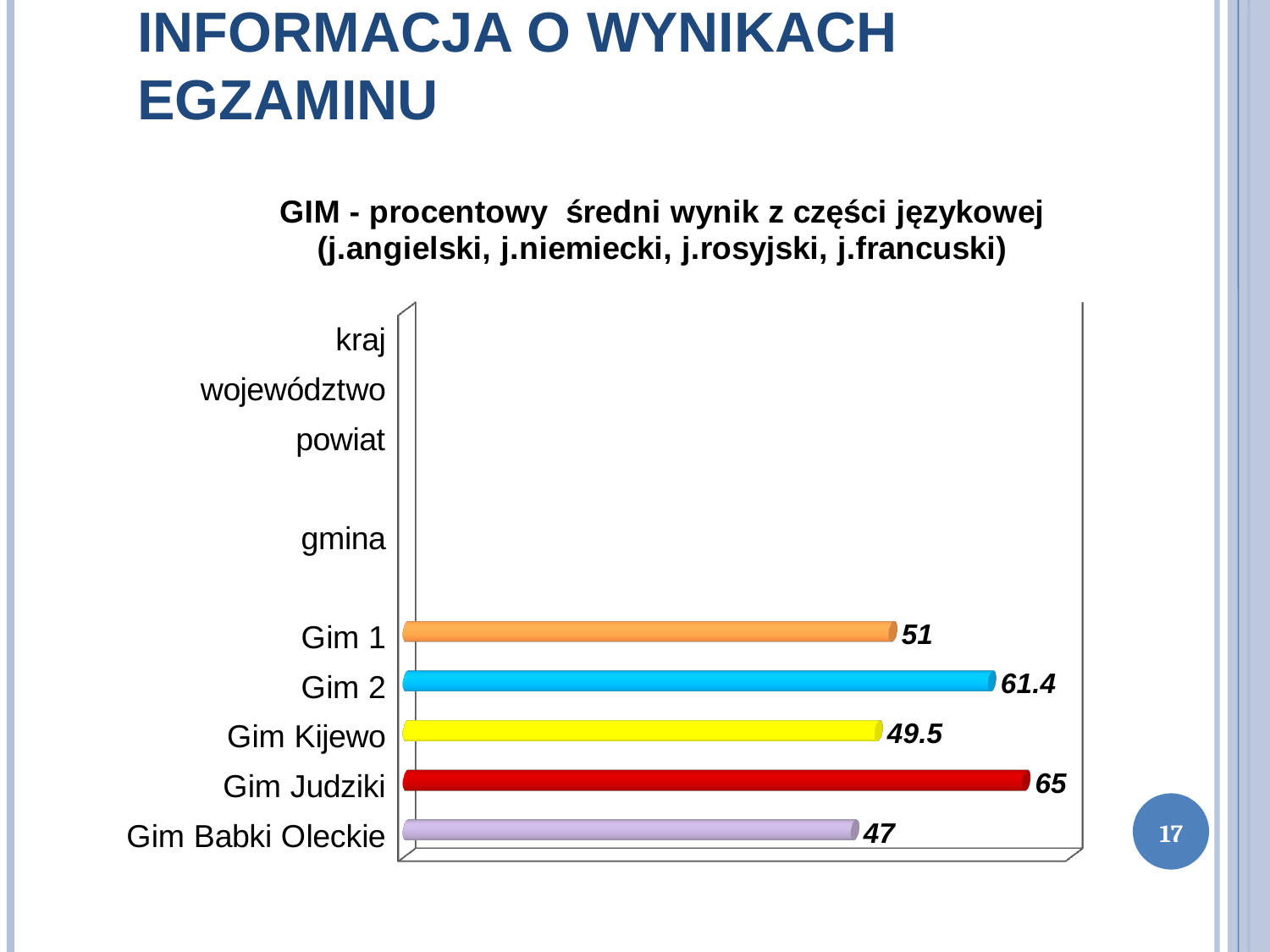
What kind of chart is shown on the slide? Bar chart Which is larger, the value for Gim 1 or the value for Gim Kijewo? Gim 1 Which category has the lowest plotted value? Gim Babki Oleckie What is the value for Gim 2? 61.4 What is the value for Gim Kijewo? 49.5 What is the value for Gim Judziki? 65 What is the value for Gim 1? 51 How many bars with data labels are plotted on the chart? 5 What is the value for Gim Babki Oleckie? 47 What is the difference between the values for Gim 2 and Gim 1? 10.4 What is the difference between the values for Gim Judziki and Gim Babki Oleckie? 18 Which category has the highest value? Gim Judziki